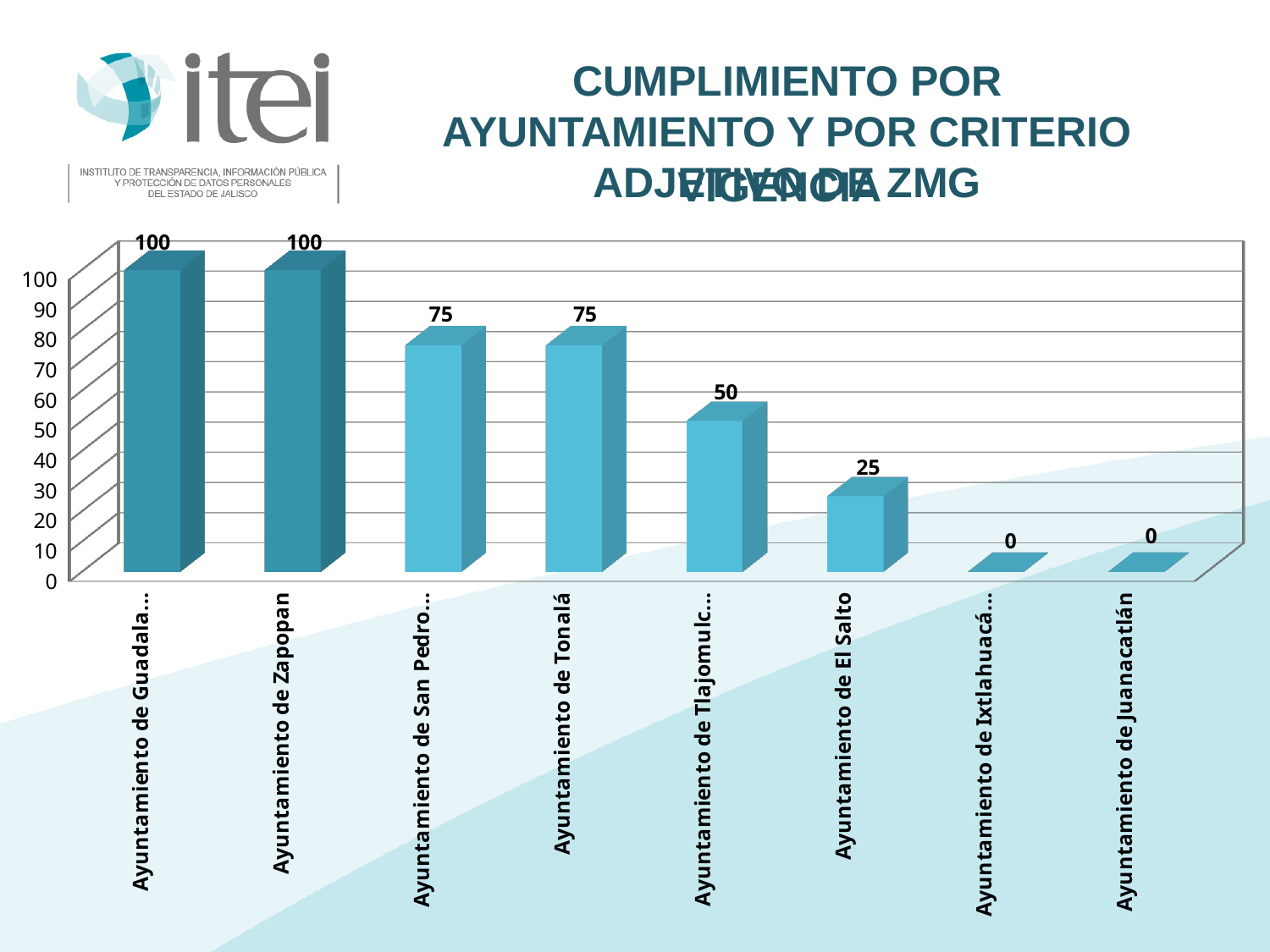
How many ayuntamientos (categories) are shown in the chart? 8 What is the value for Ayuntamiento de Tonalá? 75 What is the value for Ayuntamiento de El Salto? 25 Do the values rise or fall from left to right along the x axis? fall What is the difference between the values for Ayuntamiento de Zapopan and Ayuntamiento de Tonalá? 25 What is the value for Ayuntamiento de Zapopan? 100 What is the difference between the values for Ayuntamiento de Tonalá and Ayuntamiento de El Salto? 50 What kind of chart is shown on the slide? bar chart How many ayuntamientos have a value of 0? 2 What is the value for Ayuntamiento de Juanacatlán? 0 What is the highest tick value shown on the vertical axis? 100 Which has a larger value, Ayuntamiento de Tonalá or Ayuntamiento de El Salto? Ayuntamiento de Tonalá